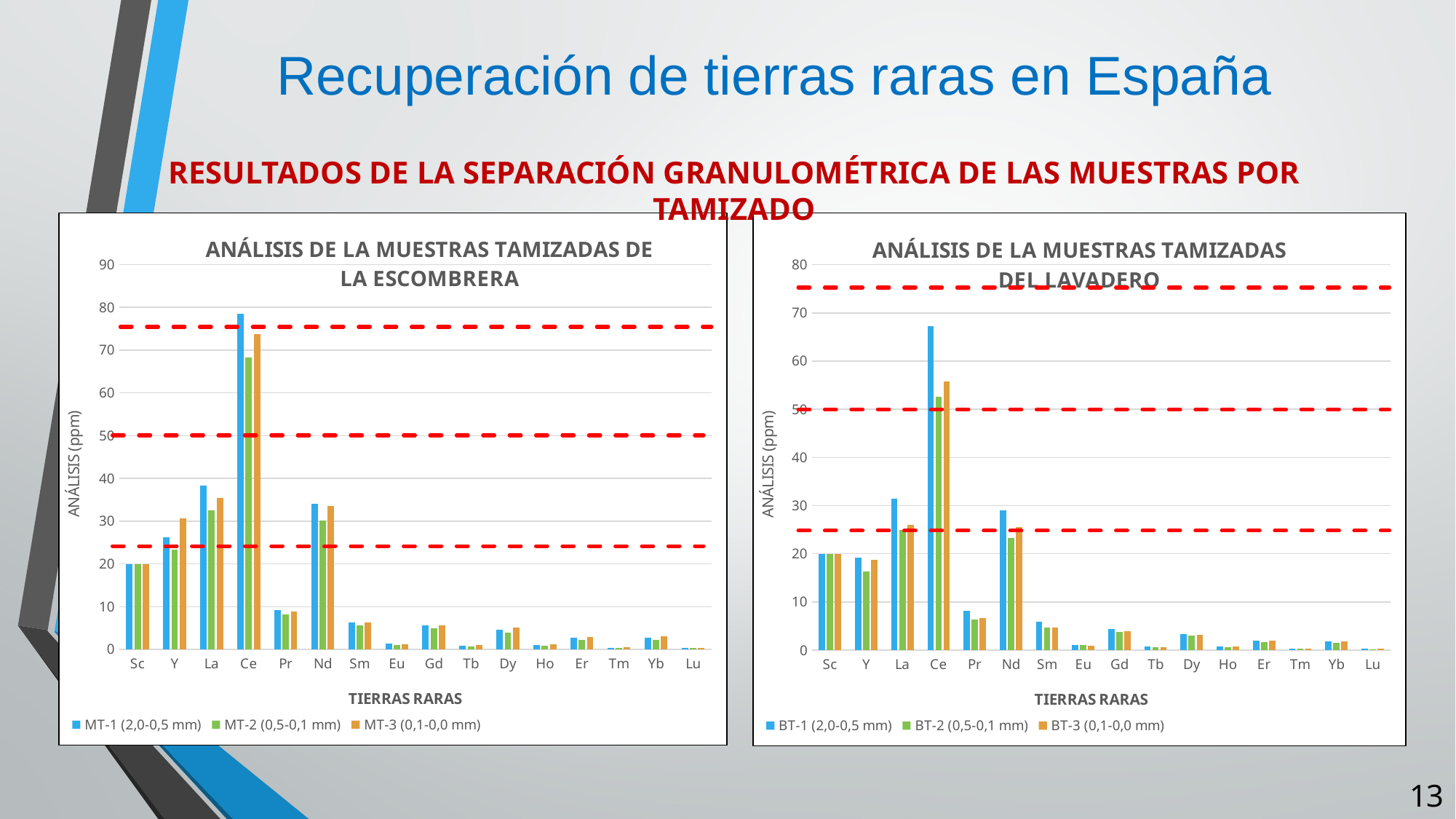
How many series does the legend of the right chart, 'ANÁLISIS DE LA MUESTRAS TAMIZADAS DEL LAVADERO', list? 3 What type of chart is the left chart, 'ANÁLISIS DE LA MUESTRAS TAMIZADAS DE LA ESCOMBRERA'? bar chart In the right chart, 'ANÁLISIS DE LA MUESTRAS TAMIZADAS DEL LAVADERO', which rare earth has the highest values? Ce In the right chart, 'ANÁLISIS DE LA MUESTRAS TAMIZADAS DEL LAVADERO', is the BT-2 (0,5-0,1 mm) value for Y greater or less than 20? less In the right chart, 'ANÁLISIS DE LA MUESTRAS TAMIZADAS DEL LAVADERO', which is larger for BT-1 (2,0-0,5 mm): Ce or La? Ce What is the y-axis label of the left chart, 'ANÁLISIS DE LA MUESTRAS TAMIZADAS DE LA ESCOMBRERA'? ANÁLISIS (ppm) In the right chart, 'ANÁLISIS DE LA MUESTRAS TAMIZADAS DEL LAVADERO', is the BT-1 (2,0-0,5 mm) value for Ce greater or less than 60? greater In the left chart, 'ANÁLISIS DE LA MUESTRAS TAMIZADAS DE LA ESCOMBRERA', is the MT-1 (2,0-0,5 mm) value for La greater or less than 30? greater In the left chart, 'ANÁLISIS DE LA MUESTRAS TAMIZADAS DE LA ESCOMBRERA', which is larger for MT-1 (2,0-0,5 mm): Nd or Sm? Nd In the left chart, 'ANÁLISIS DE LA MUESTRAS TAMIZADAS DE LA ESCOMBRERA', which rare earth has the highest values? Ce How many rare earth categories are shown on the x axis of the left chart, 'ANÁLISIS DE LA MUESTRAS TAMIZADAS DE LA ESCOMBRERA'? 16